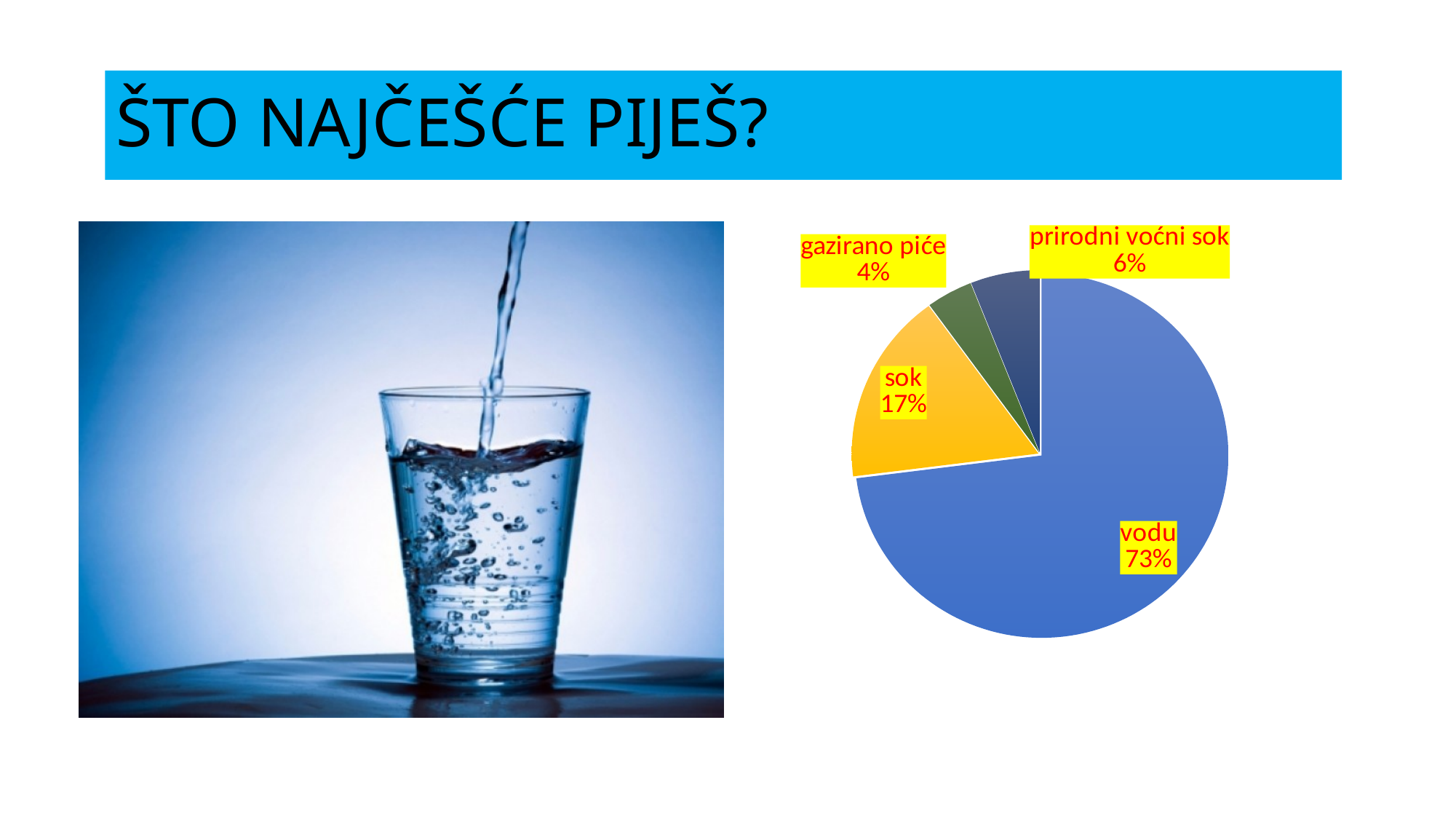
What is the difference in percentage points between "vodu" and "sok"? 56 Which is larger, the share for "prirodni voćni sok" or for "gazirano piće"? prirodni voćni sok How many slices does the pie chart have? 4 What share of the pie does "gazirano piće" have? 4% What share of the pie does "vodu" have? 73% Which category has the smallest slice of the pie? gazirano piće Which category has the largest slice of the pie? vodu What share of the pie does "sok" have? 17% What colour is the "sok" slice of the pie? orange What kind of chart is shown on the slide? pie chart What is the difference in percentage points between "sok" and "prirodni voćni sok"? 11